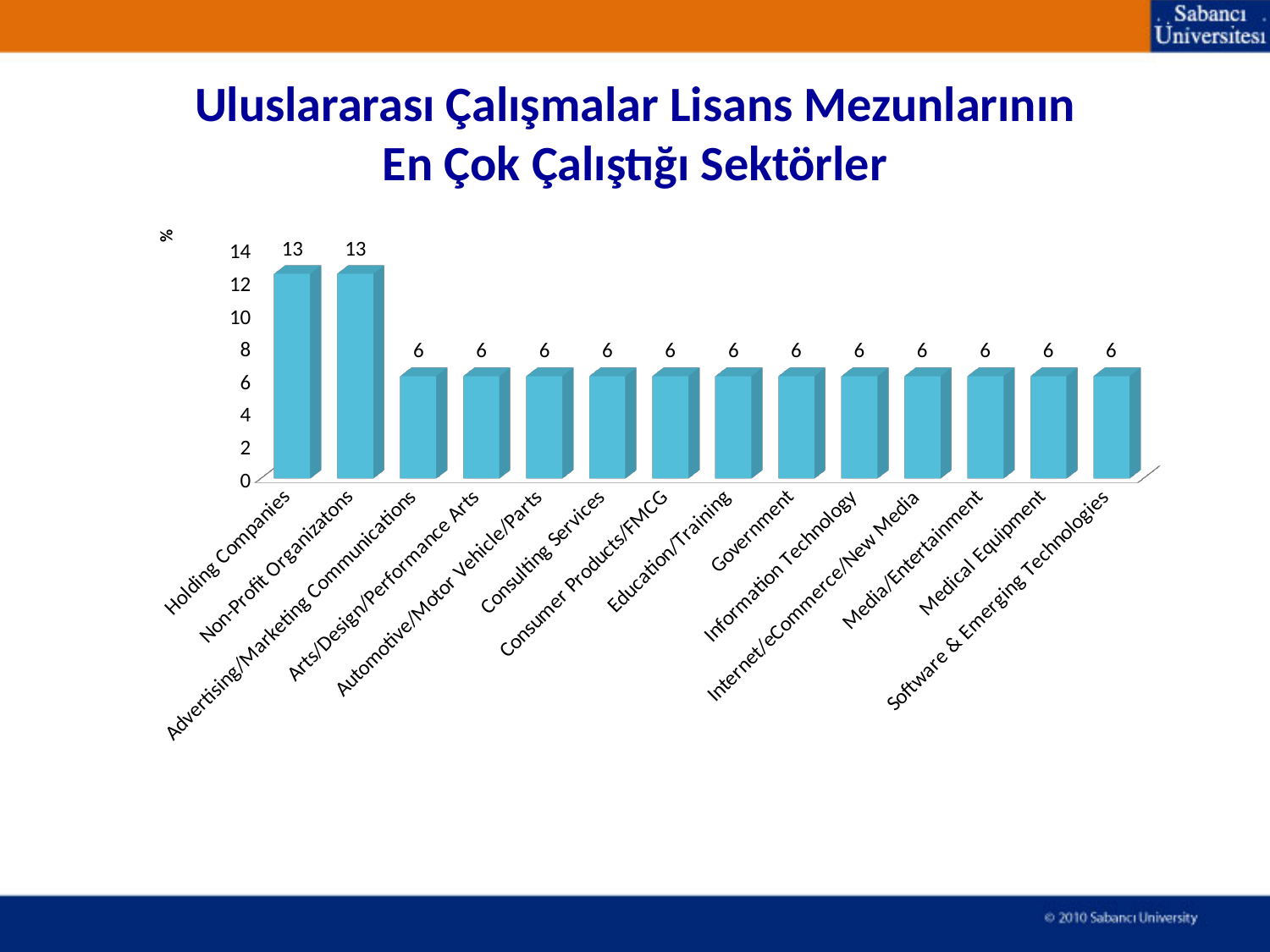
Is the value for Information Technology greater or less than 10? less What is the value for Non-Profit Organizatons? 13 What kind of chart is shown on the slide? bar chart Which is larger, the value for Non-Profit Organizatons or the value for Medical Equipment? Non-Profit Organizatons Is the value for Holding Companies greater or less than 10? greater What unit is shown on the y axis label? % What is the value for Holding Companies? 13 What is the value for Government? 6 How many categories are shown on the x axis? 14 What is the value for Education/Training? 6 What is the difference between the values for Holding Companies and Consulting Services? 7 What is the value for Software & Emerging Technologies? 6